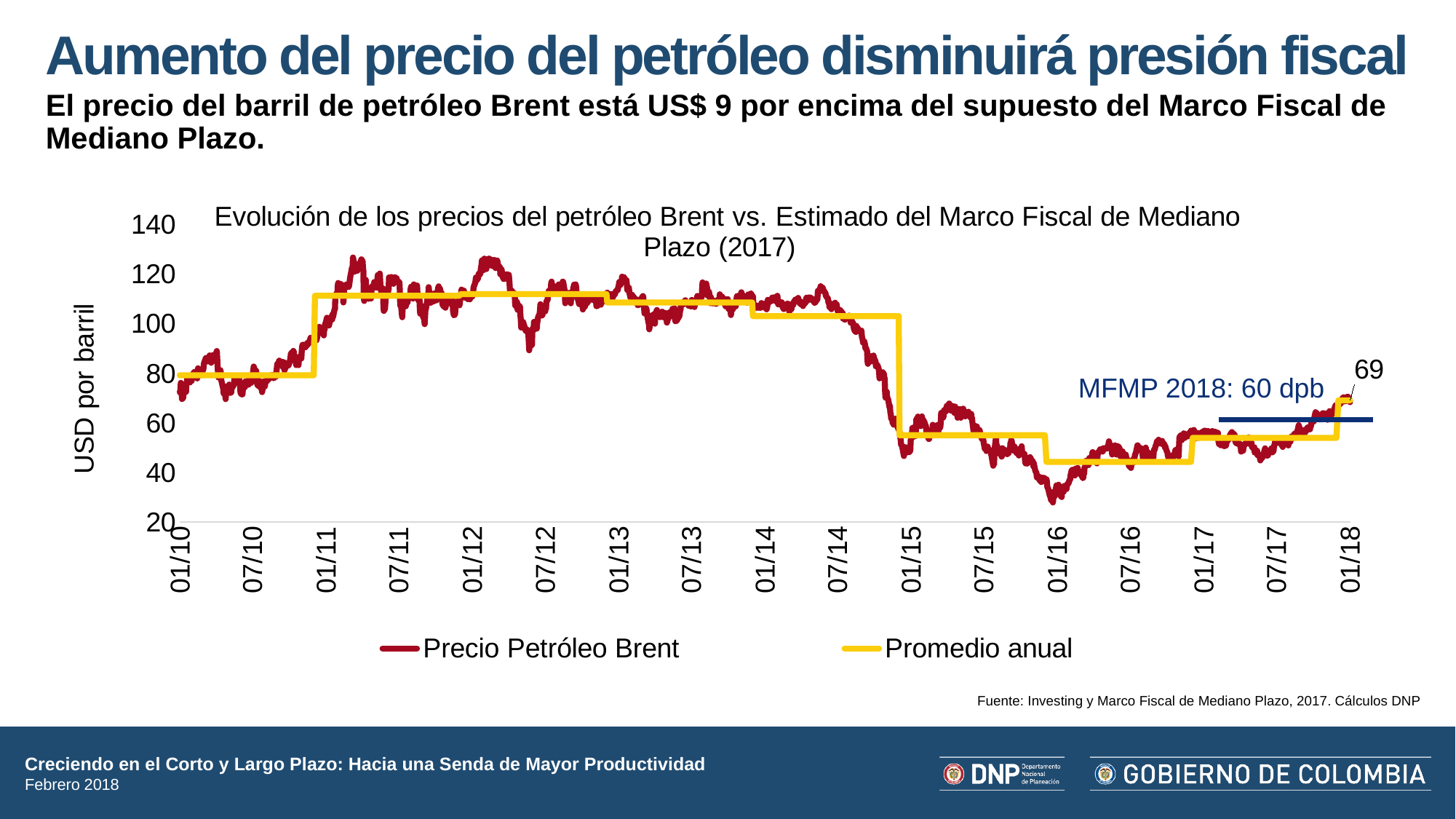
Is the Precio Petróleo Brent value around 01/16 greater or less than 40? less Does the Precio Petróleo Brent series rise or fall between 07/14 and 01/15? fall How many series does the chart legend list? 2 What is the last labelled value of the Precio Petróleo Brent series at the right end of the chart? 69 Which is higher, the Promedio anual for 2012 or for 2016? 2012 Is the Promedio anual value for 2016 greater or less than 60? less Is the Promedio anual value for 2010 greater or less than 100? less What is the label on the vertical axis of the chart? USD por barril What kind of chart is shown on the slide? line chart What is the difference between the last labelled Brent price (69) and the MFMP 2018 value (60)? 9 What value does the chart annotation give for MFMP 2018? 60 dpb